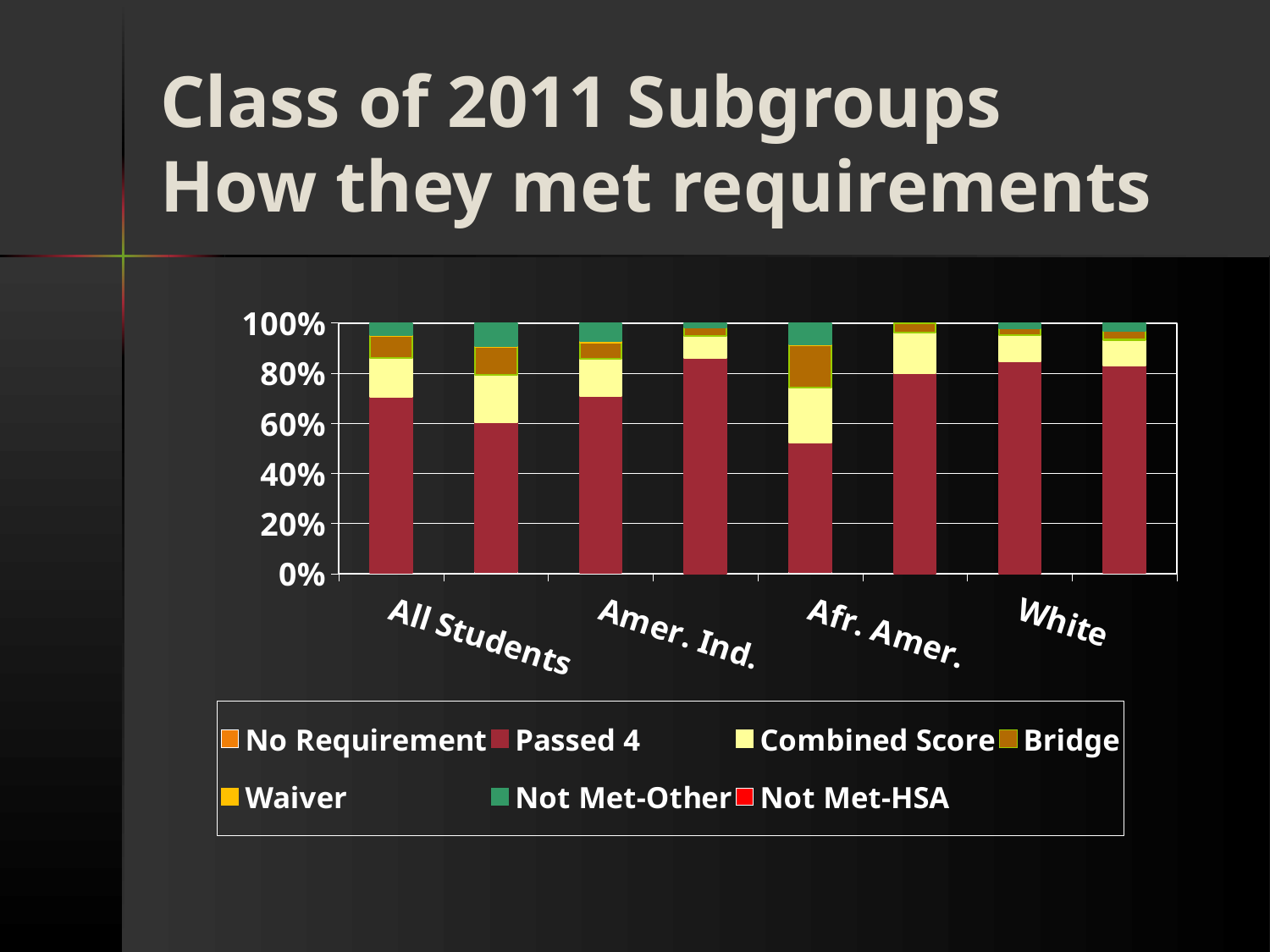
What colour represents the Passed 4 series in the legend? Dark red Among the labelled subgroups (All Students, Amer. Ind., Afr. Amer., White), which has the highest Passed 4 share? White How many bars are plotted in the chart? 8 Among the labelled subgroups (All Students, Amer. Ind., Afr. Amer., White), which has the lowest Passed 4 share? Afr. Amer. How many series does the legend list? 7 What kind of chart is shown on the slide? Stacked bar chart Is the Passed 4 value for White greater or less than 80%? greater Which has the larger Passed 4 share, White or Afr. Amer.? White Is the Passed 4 value for Afr. Amer. greater or less than 60%? less What is the total height of the stacked bar for White? 100% Is the Passed 4 value for Amer. Ind. greater or less than 80%? less